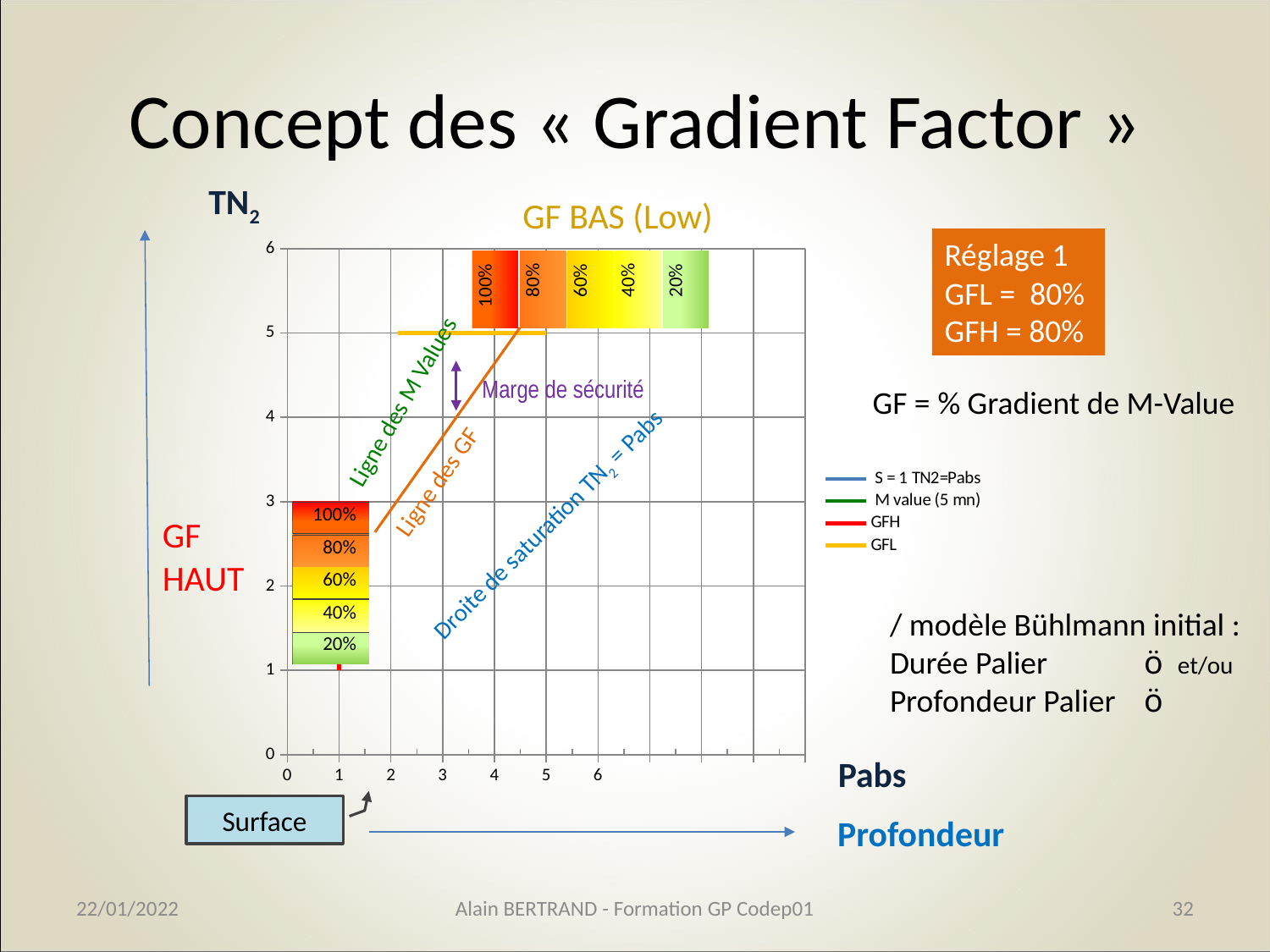
How many series does the chart legend list? 4 Does the 'Ligne des GF' line rise or fall as the horizontal axis value increases? rise How many numbered tick labels are shown on the horizontal axis of the chart? 7 What kind of chart is shown on the slide? line chart At which vertical-axis value is the horizontal GFL line drawn? 5 What colour is the GFH series in the chart legend? red How many percentage bands (100%, 80%, 60%, 40%, 20%) are shown in each coloured scale on the chart? 5 What is the highest value shown on the vertical axis of the chart? 6